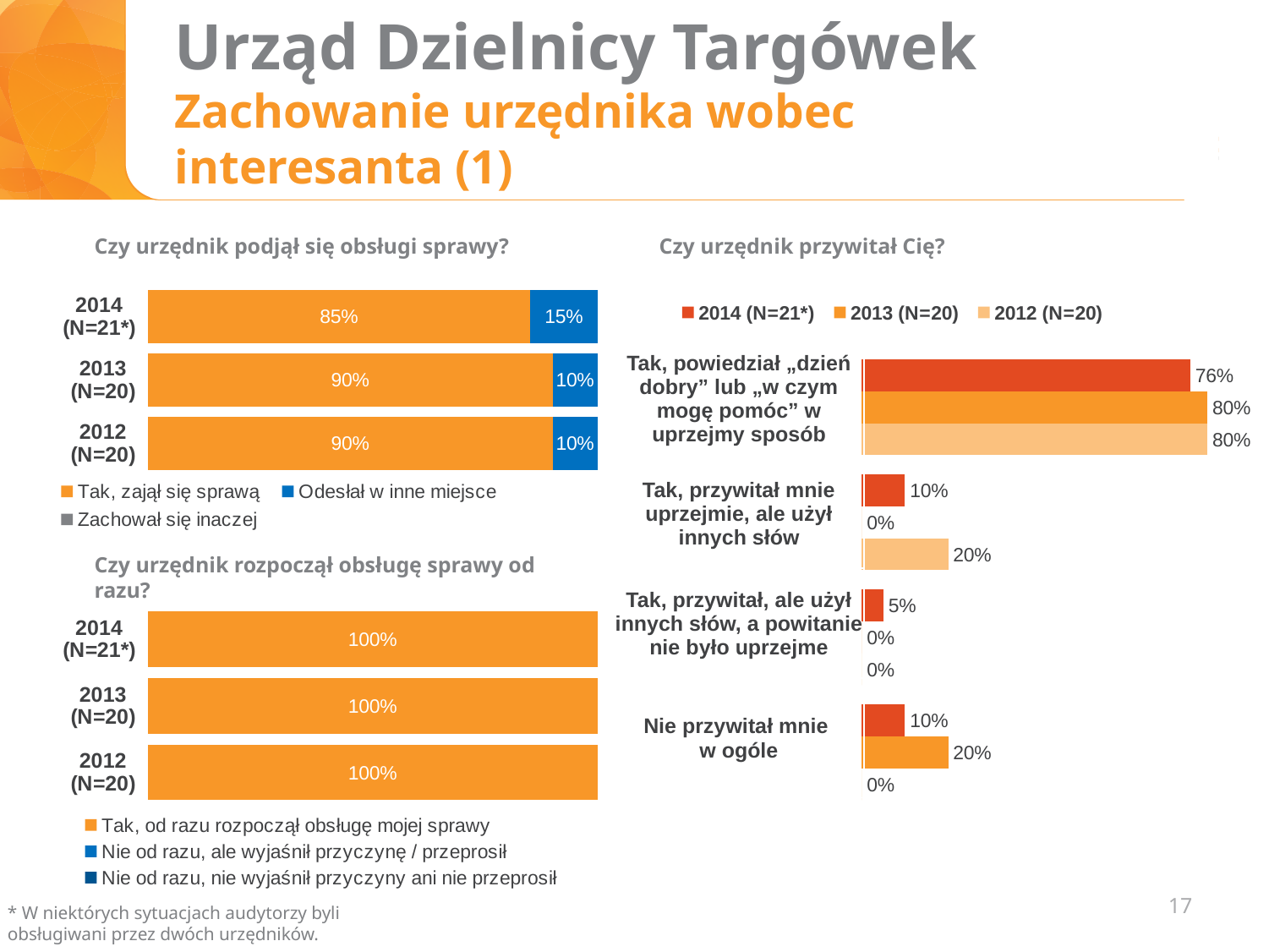
In the chart "Czy urzędnik przywitał Cię?", which is larger for "Nie przywitał mnie w ogóle": the 2014 (N=21*) value or the 2013 (N=20) value? 2013 (N=20) How many categories are shown on the y axis of the chart "Czy urzędnik przywitał Cię?"? 4 In the chart "Czy urzędnik podjął się obsługi sprawy?", which year has the lowest share of "Tak, zajął się sprawą"? 2014 (N=21*) In the chart "Czy urzędnik przywitał Cię?", what is the 2014 (N=21*) value for "Tak, powiedział „dzień dobry” lub „w czym mogę pomóc” w uprzejmy sposób"? 76% In the chart "Czy urzędnik podjął się obsługi sprawy?", what percentage for 2014 (N=21*) is "Tak, zajął się sprawą"? 85% How many series does the legend of the chart "Czy urzędnik przywitał Cię?" list? 3 How many entries does the legend of the chart "Czy urzędnik podjął się obsługi sprawy?" list? 3 In the chart "Czy urzędnik podjął się obsługi sprawy?", what percentage for 2014 (N=21*) is "Odesłał w inne miejsce"? 15% In the chart "Czy urzędnik rozpoczął obsługę sprawy od razu?", what percentage for 2013 (N=20) is "Tak, od razu rozpoczął obsługę mojej sprawy"? 100% In the chart "Czy urzędnik przywitał Cię?", what is the 2012 (N=20) value for "Tak, przywitał mnie uprzejmie, ale użył innych słów"? 20% What kind of chart is "Czy urzędnik rozpoczął obsługę sprawy od razu?"? Bar chart In the chart "Czy urzędnik podjął się obsługi sprawy?", what is the difference between the "Tak, zajął się sprawą" share in 2013 (N=20) and in 2014 (N=21*)? 5 percentage points